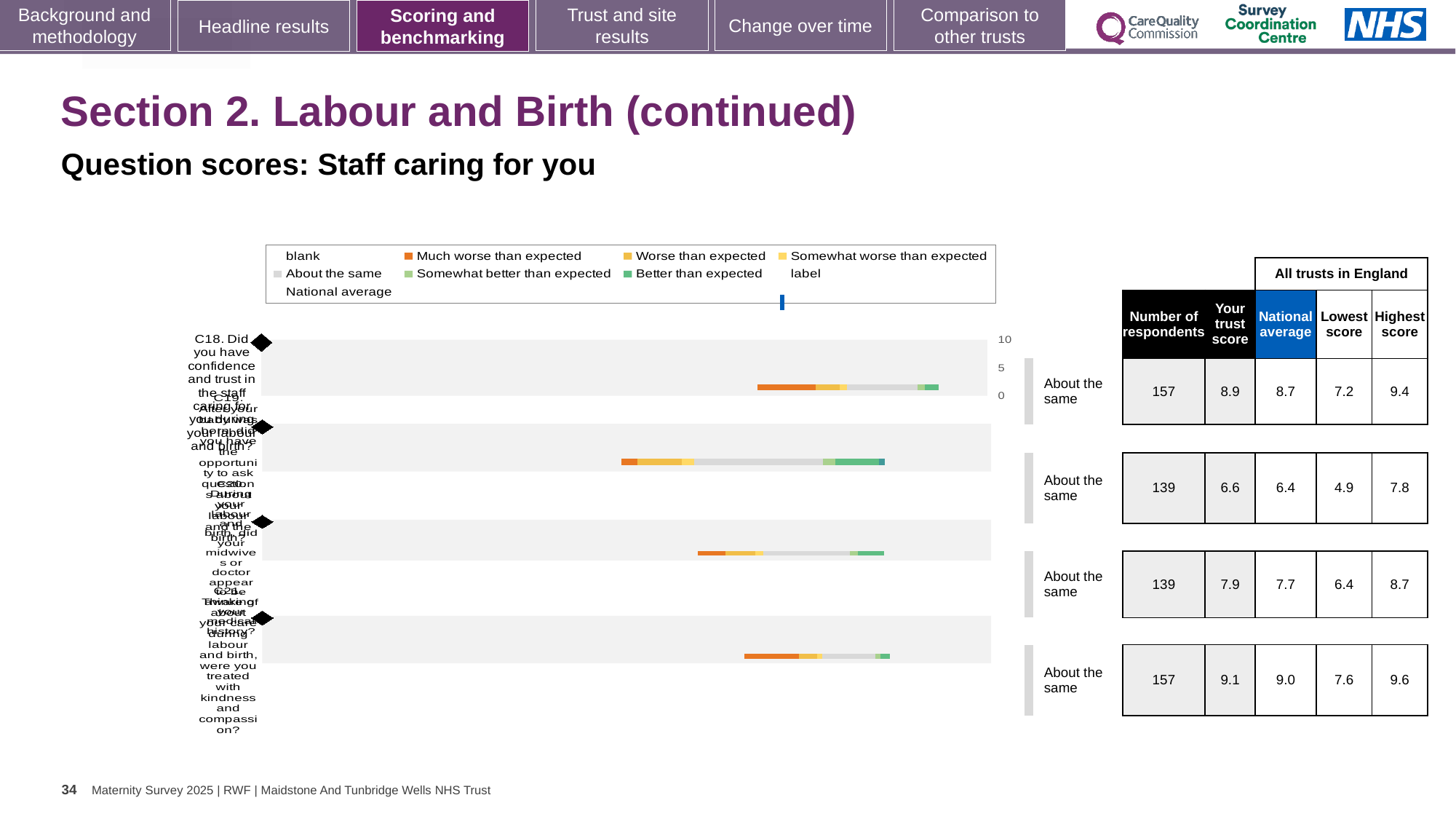
What is the highest score among all trusts in England for the fourth row (C21)? 9.6 What kind of chart is shown on the slide? bar chart What is the 'Your trust score' for the first row (C18, confidence and trust in the staff caring for you)? 8.9 Which row has the lowest 'Your trust score'? the second row (C19), 6.6 How many respondents are listed for the second row (C19)? 139 For the third row (C20), which is larger: the trust score or the national average? the trust score (7.9) Which row has the highest 'Your trust score'? the fourth row (C21), 9.1 How many questions (rows) are plotted in the chart? 4 For the second row (C19), what is the difference between the highest score and the lowest score among all trusts in England? 2.9 What benchmark category is shown next to each of the four rows? About the same For the first row (C18), what is the difference between the trust score and the national average? 0.2 What is the national average for the first row (C18)? 8.7